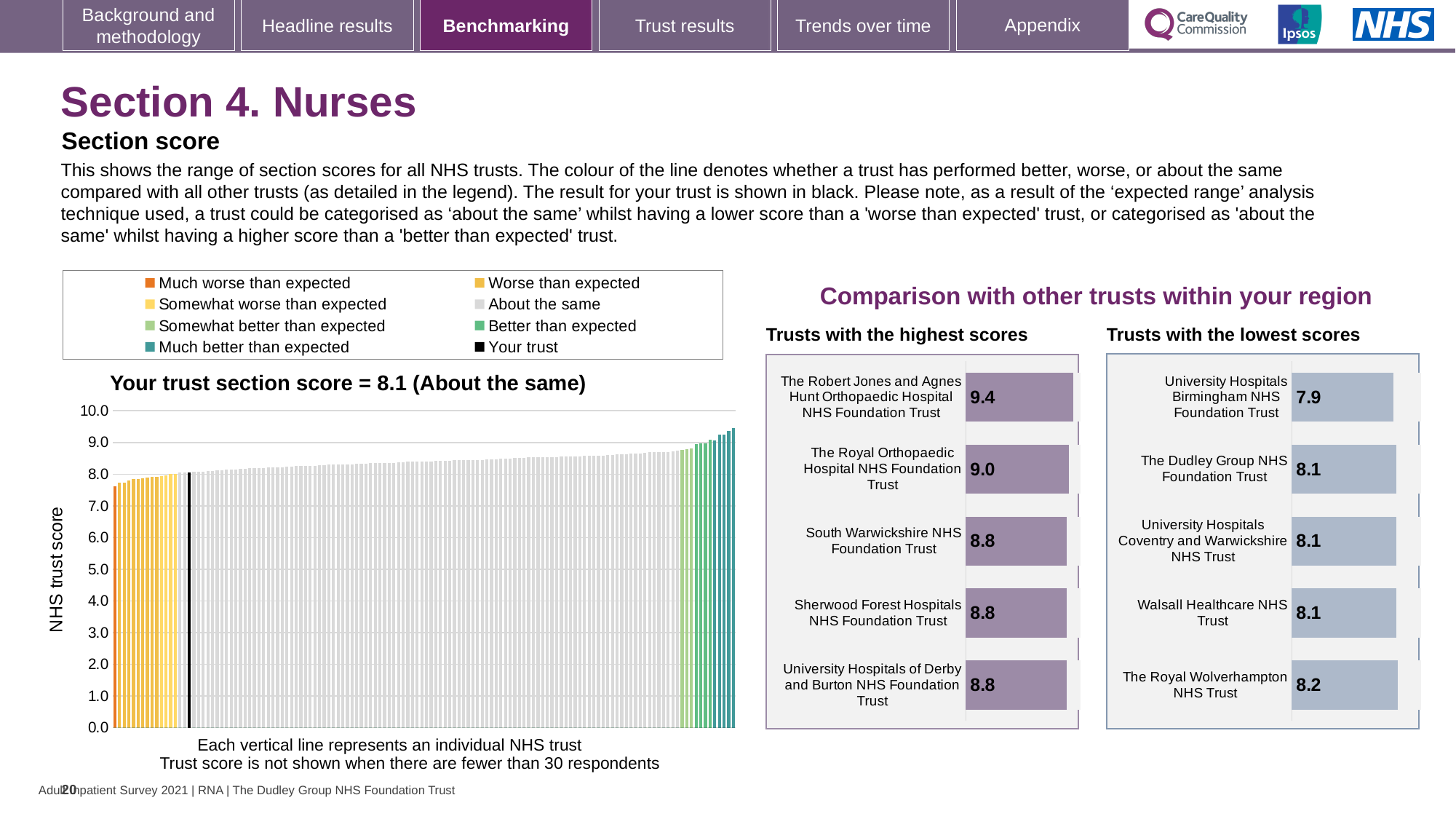
In the 'Trusts with the highest scores' chart, what is the score for The Robert Jones and Agnes Hunt Orthopaedic Hospital NHS Foundation Trust? 9.4 In the 'Trusts with the highest scores' chart, which has the larger score: The Royal Orthopaedic Hospital NHS Foundation Trust or South Warwickshire NHS Foundation Trust? The Royal Orthopaedic Hospital NHS Foundation Trust In the 'Trusts with the highest scores' chart, which trust has the highest score? The Robert Jones and Agnes Hunt Orthopaedic Hospital NHS Foundation Trust In the 'Trusts with the lowest scores' chart, what is the score for University Hospitals Birmingham NHS Foundation Trust? 7.9 How many trusts are listed in the 'Trusts with the highest scores' chart? 5 According to the title of the chart on the left, what is your trust's section score? 8.1 In the 'Trusts with the lowest scores' chart, which trust has the lowest score? University Hospitals Birmingham NHS Foundation Trust In the 'Your trust section score' chart on the left, do the values rise or fall from left to right along the x axis? Rise What kind of chart is the 'Your trust section score' chart on the left of the slide? Bar chart In the 'Trusts with the highest scores' chart, what is the difference between the scores of The Robert Jones and Agnes Hunt Orthopaedic Hospital NHS Foundation Trust and The Royal Orthopaedic Hospital NHS Foundation Trust? 0.4 In the 'Trusts with the lowest scores' chart, what is the difference between the scores of The Royal Wolverhampton NHS Trust and University Hospitals Birmingham NHS Foundation Trust? 0.3 How many entries does the legend above the 'Your trust section score' chart list? 8